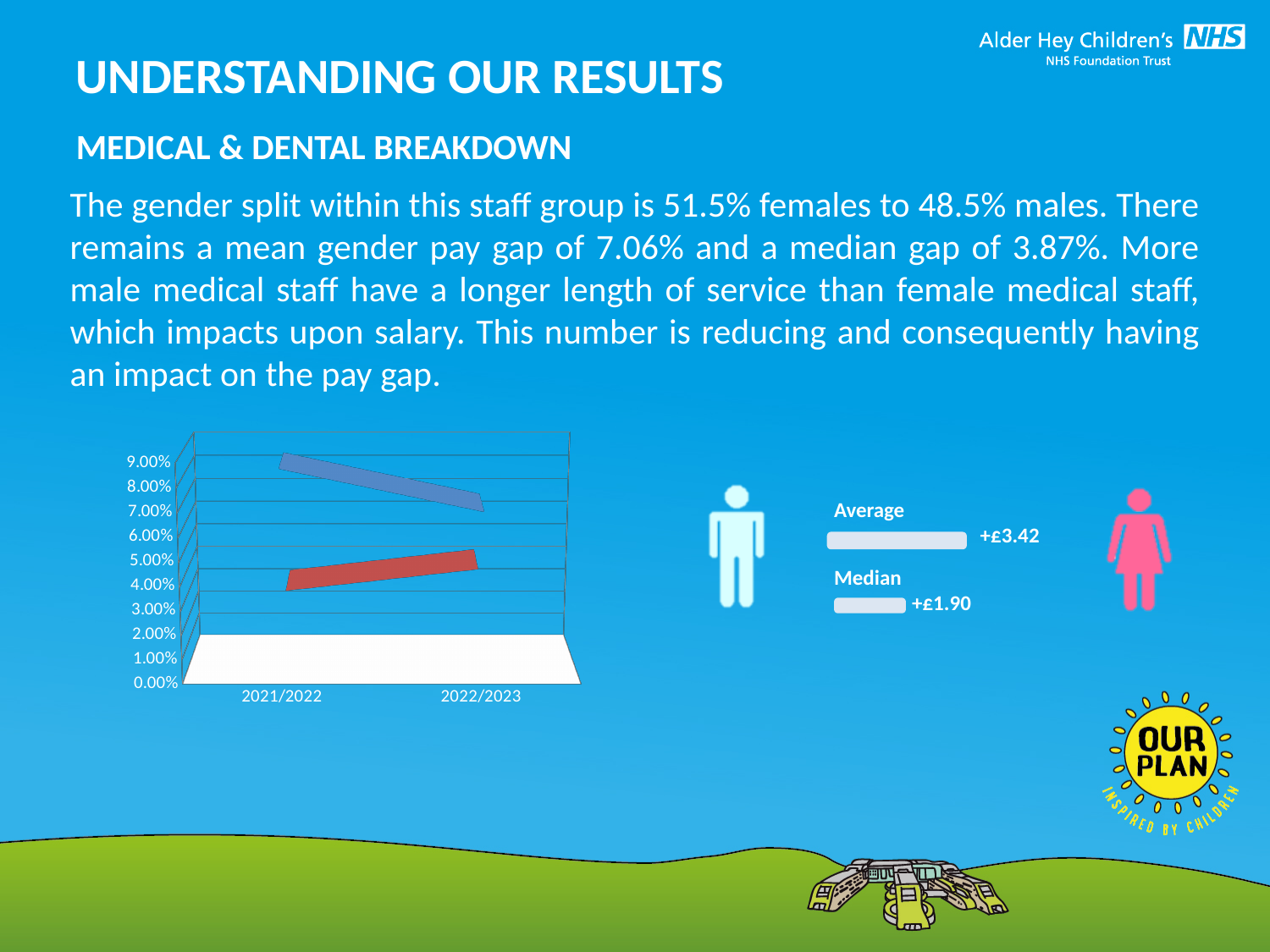
What is the highest value labelled on the y axis of the chart on the left? 9.00% In the chart on the left, is the value of the blue series for 2021/2022 greater or less than 8.00%? greater What are the two category labels on the x axis of the chart on the left? 2021/2022 and 2022/2023 In the chart on the left, does the blue series rise or fall from 2021/2022 to 2022/2023? fall What kind of chart is shown on the left of the slide? line chart How many data series are plotted in the chart on the left? 2 In the chart on the left, is the value of the blue series for 2022/2023 greater or less than 8.00%? less How many categories are shown on the x axis of the chart on the left? 2 In the chart on the left, does the red series rise or fall from 2021/2022 to 2022/2023? rise In the chart on the left, is the value of the red series for 2021/2022 greater or less than 5.00%? less In the chart on the left, which series has the higher value for 2022/2023, the blue series or the red series? blue series